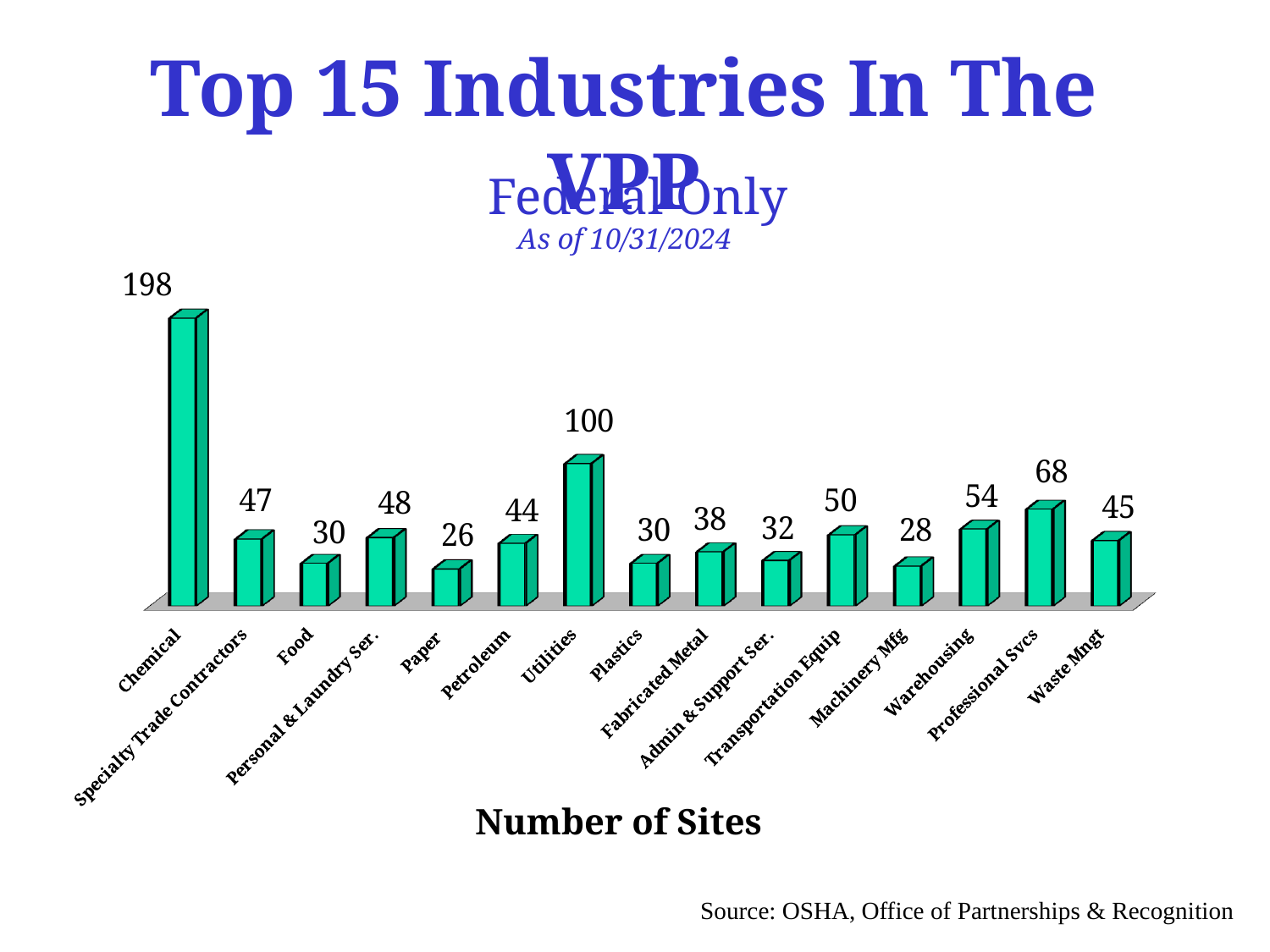
What type of chart is shown on the slide? Bar chart How many industries are shown in the chart? 15 What is the value shown for Professional Svcs? 68 Which industry has the highest number of sites? Chemical Which has more sites, Petroleum or Waste Mngt? Waste Mngt How many sites does the Chemical industry have? 198 What is the label on the horizontal axis of the chart? Number of Sites What is the number of sites for Utilities? 100 Which industry has the lowest number of sites? Paper What is the difference between the values for Professional Svcs and Warehousing? 14 Which has more sites, Transportation Equip or Fabricated Metal? Transportation Equip What is the difference in number of sites between Chemical and Utilities? 98